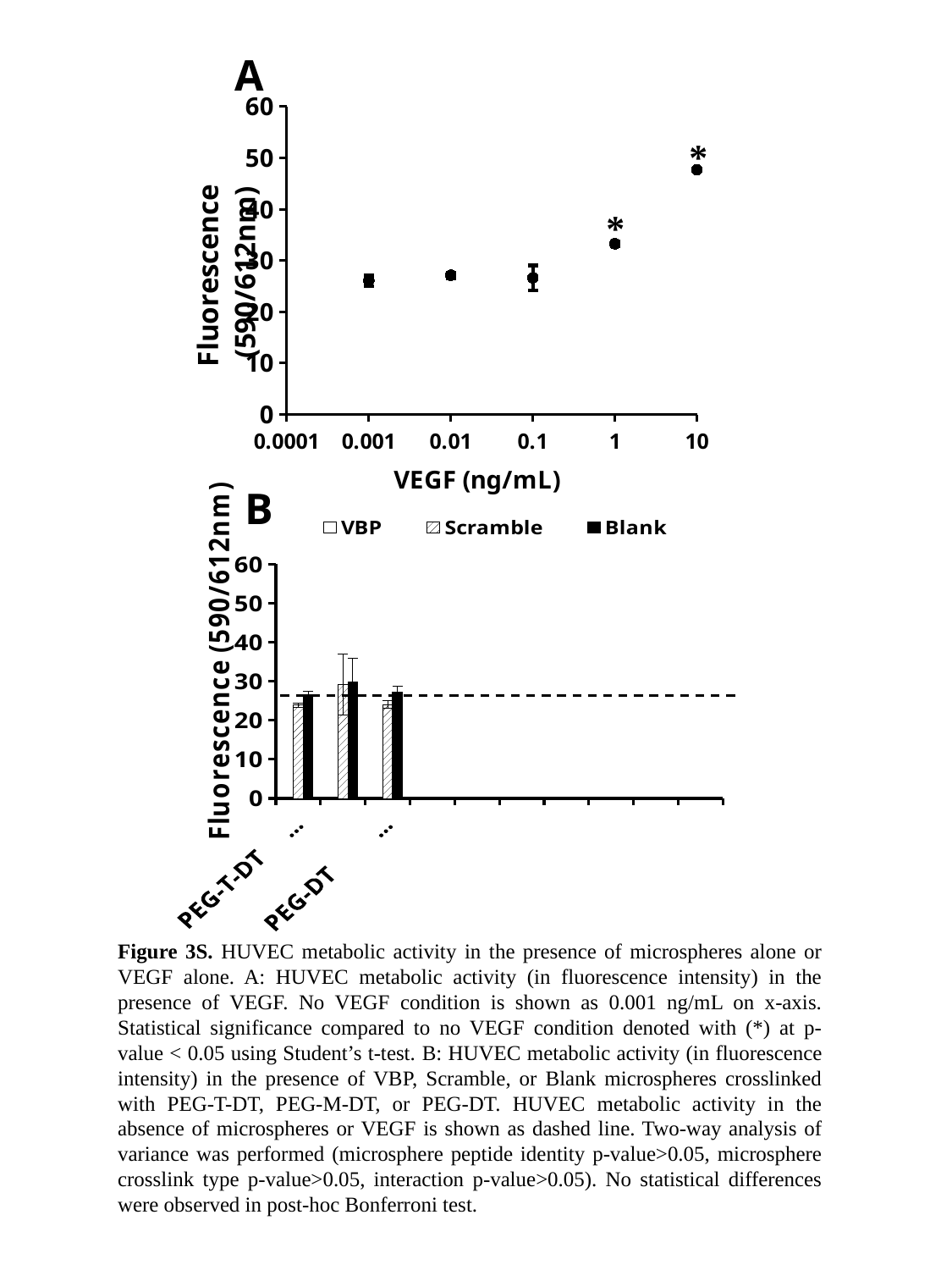
In chart A (top), is the fluorescence value at 1 ng/mL VEGF greater or less than 30? greater In chart B (bottom), is the Blank bar for PEG-T-DT greater or less than 20? greater What kind of chart is chart B (bottom)? bar chart In chart A (top), how many data points are marked with an asterisk? 2 In chart A (top), does fluorescence generally rise or fall as VEGF concentration increases? rise In chart A (top), which of the two values is larger: the fluorescence at 10 ng/mL or at 1 ng/mL VEGF? 10 ng/mL In chart B (bottom), which legend series is drawn as a solid black bar? Blank In chart A (top), at which VEGF concentration is the fluorescence highest? 10 ng/mL In chart A (top), is the fluorescence value at 0.001 ng/mL VEGF greater or less than 30? less In chart A (top), how many VEGF concentrations have a plotted data point? 5 How many series does the legend of chart B (bottom) list? 3